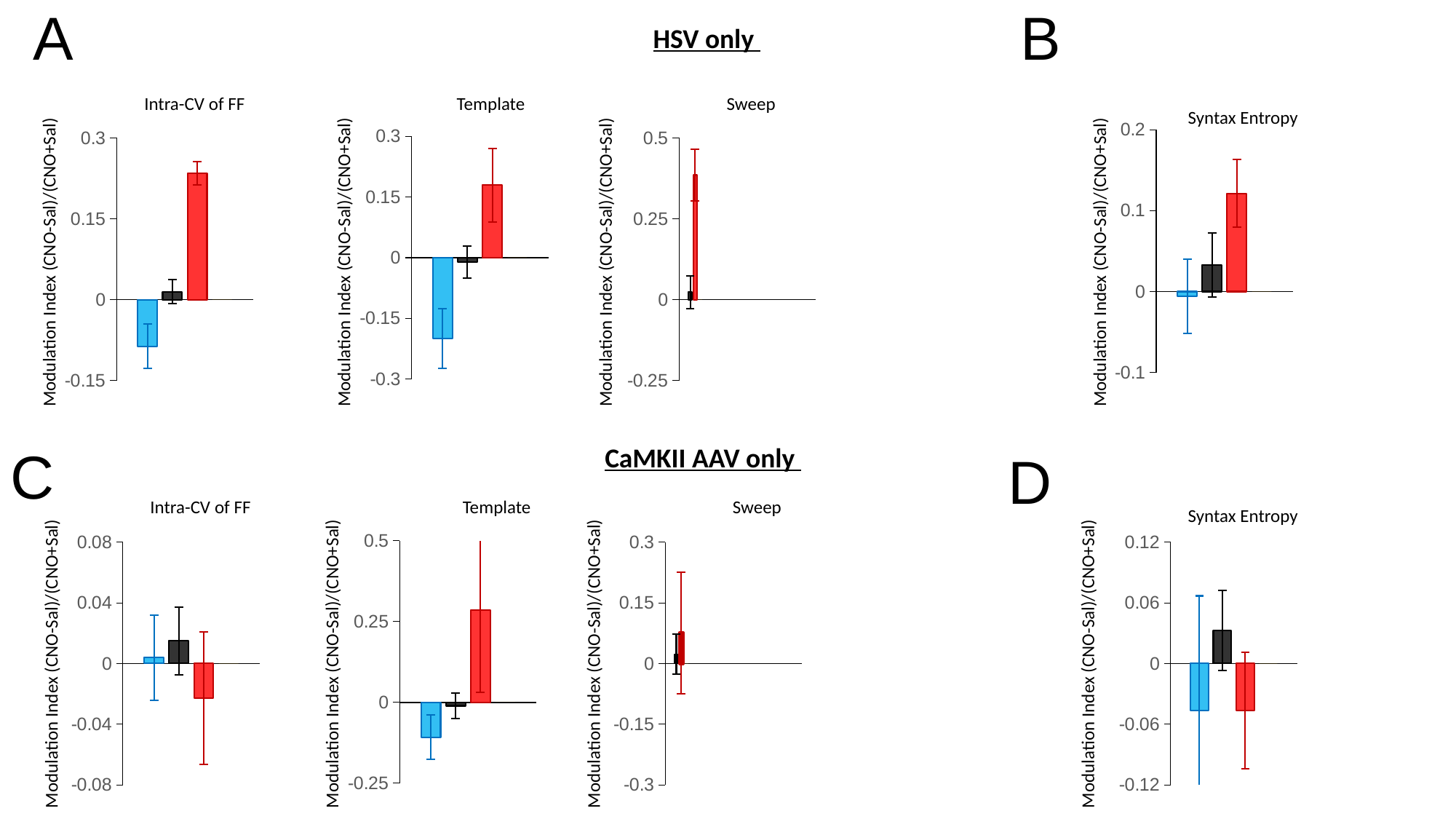
In the 'Intra-CV of FF' chart under 'CaMKII AAV only', is the value of the red bar greater or less than 0? less What kind of chart is used in the 'Intra-CV of FF' panel under 'HSV only'? bar chart In the 'Intra-CV of FF' chart under 'HSV only', is the value of the red bar greater or less than 0.15? greater In the 'Syntax Entropy' chart in panel B, is the value of the red bar greater or less than 0.1? greater In the 'Intra-CV of FF' chart under 'HSV only', which bar is the highest? the red bar What is the y-axis label of the 'Syntax Entropy' chart in panel B? Modulation Index (CNO-Sal)/(CNO+Sal) In the 'Template' chart under 'CaMKII AAV only', which is larger, the blue bar or the black bar? the black bar In the 'Syntax Entropy' chart in panel D, which bar is the highest? the black bar In the 'Template' chart under 'HSV only', which bar is the lowest? the blue bar In the 'Intra-CV of FF' chart under 'HSV only', how many bars are plotted? 3